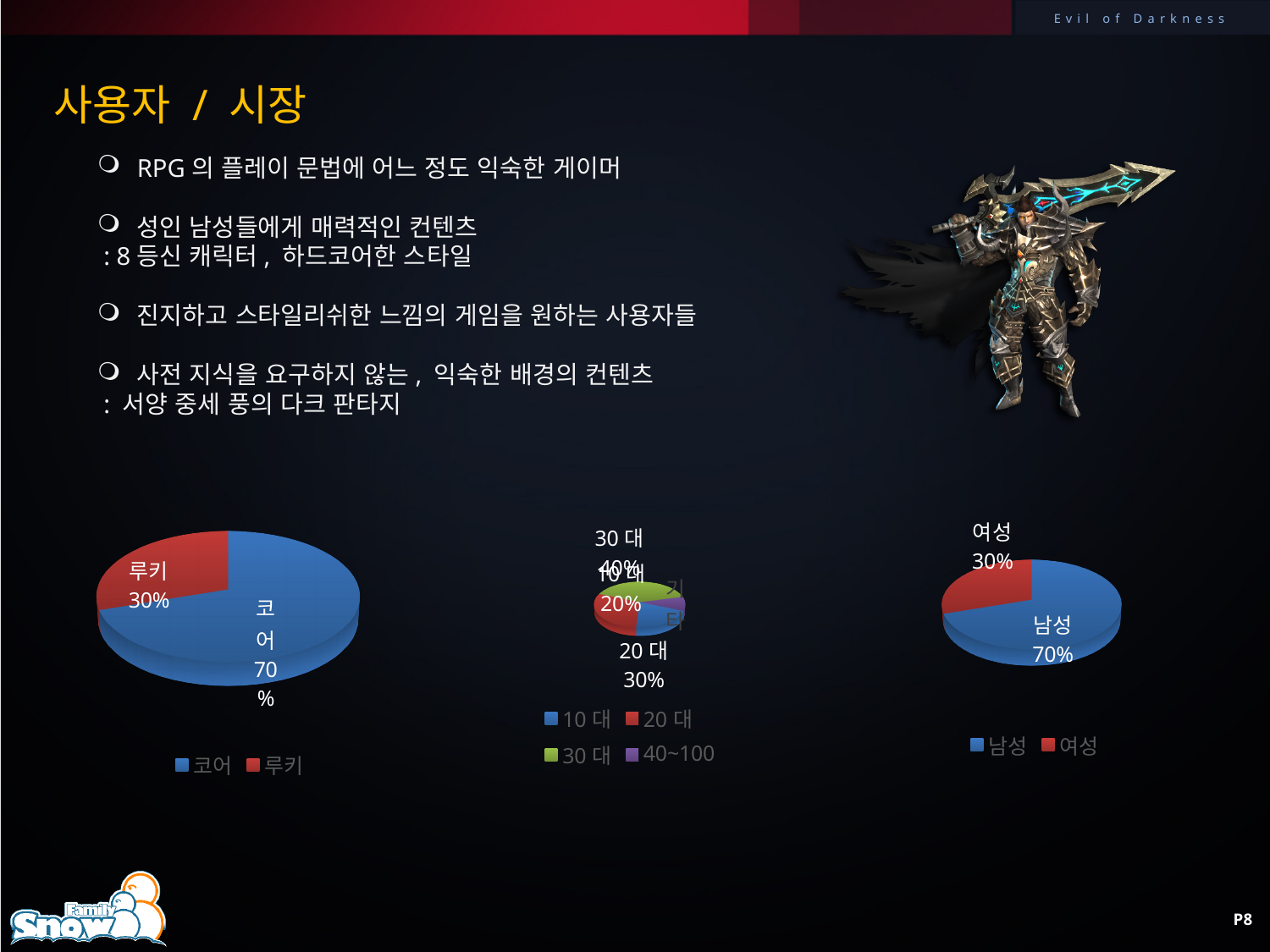
In the right pie chart, what share does 남성 have? 70% In the left pie chart, what is the difference between the 코어 and 루키 shares? 40% How many entries does the legend of the left pie chart list? 2 How many entries does the legend of the middle pie chart list? 4 What kind of chart is the left chart on the slide? pie chart In the middle pie chart, what share does 20 대 have? 30% In the left pie chart, what share does 코어 have? 70% In the left pie chart, what share does 루키 have? 30% In the left pie chart, which slice is larger, 코어 or 루키? 코어 In the right pie chart, which slice is the largest? 남성 In the right pie chart, what colour is the 여성 slice? red In the right pie chart, what share does 여성 have? 30%